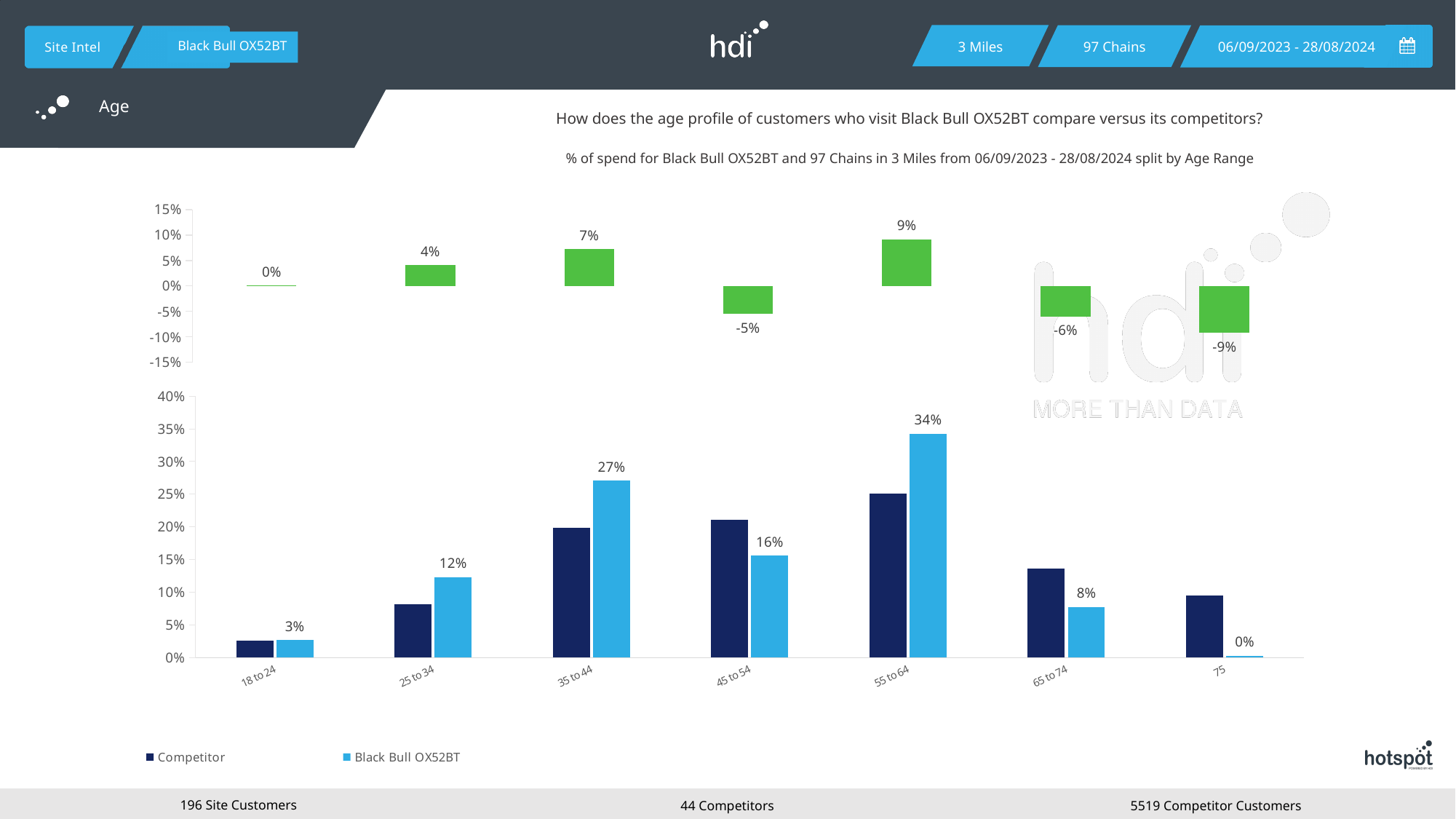
In the bottom chart, which age range has the highest Black Bull OX52BT value? 55 to 64 In the bottom chart, what is the difference between the Black Bull OX52BT values for 55 to 64 and 45 to 54? 18% In the bottom chart, for the 65 to 74 age range, which is larger: Competitor or Black Bull OX52BT? Competitor In the bottom chart, is the Competitor value for 45 to 54 greater or less than 20%? greater In the bottom chart, which age range has the lowest Black Bull OX52BT value? 75 In the bottom chart, is the Competitor value for 25 to 34 greater or less than 10%? less How many age range categories are shown on the x axis of the bottom chart? 7 In the bottom chart, what is the value for Black Bull OX52BT in the 55 to 64 age range? 34% In the bottom chart, what is the value for Black Bull OX52BT in the 35 to 44 age range? 27% How many series does the legend of the bottom chart list? 2